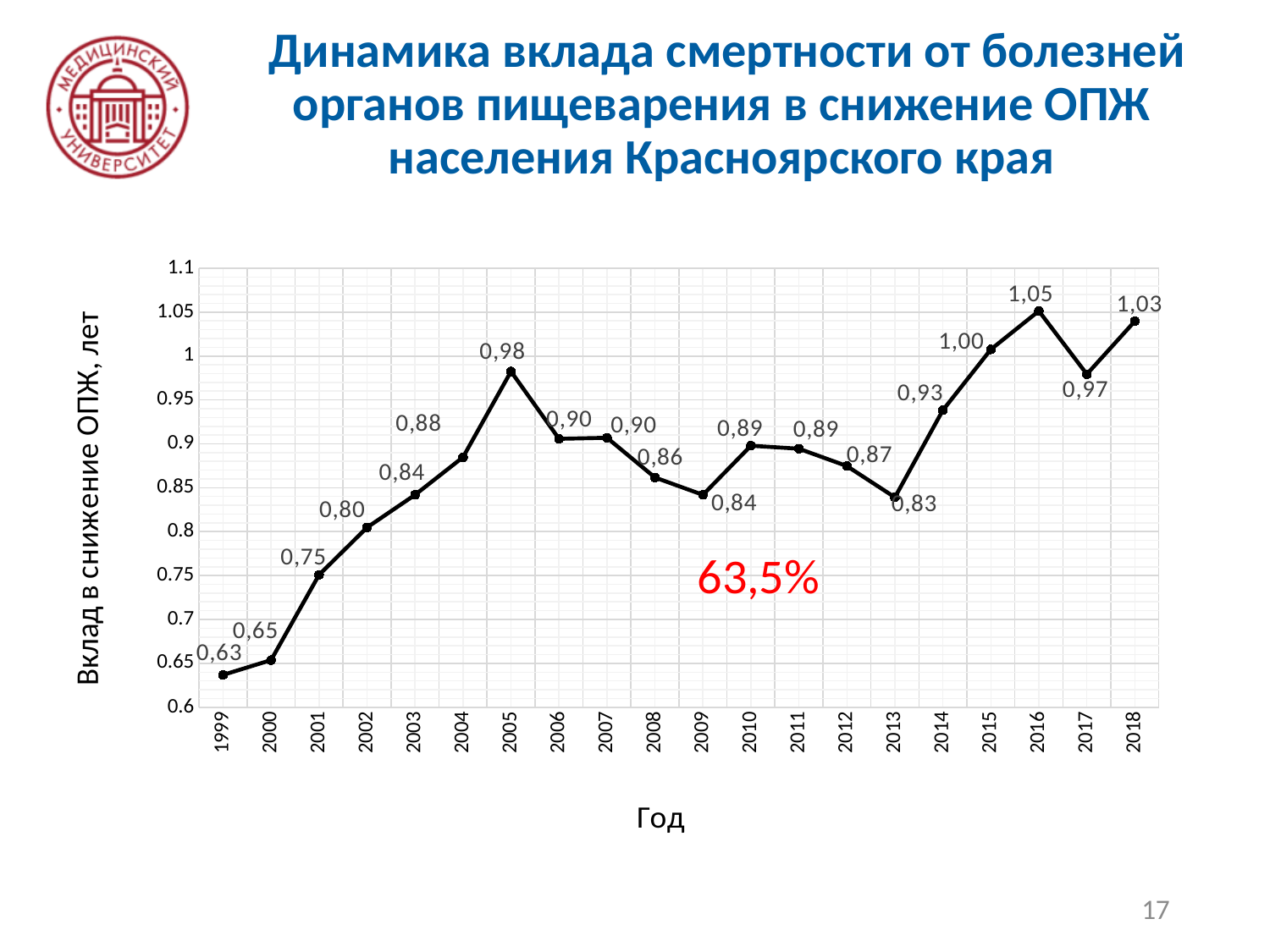
What is the value for 2005? 0,98 What is the difference between the values for 2018 and 1999? 0,40 What is the value for 2013? 0,83 How many years are plotted on the chart? 20 Is the value for 2001 greater or less than 0.8? less What type of chart is shown on the slide? line chart Overall, do the values rise or fall from 1999 to 2018? rise What is the value for 2018? 1,03 Which year has the lowest value? 1999 Which year has the highest value? 2016 What is the label of the vertical axis? Вклад в снижение ОПЖ, лет Which is larger, the value for 2005 or the value for 2014? 2005